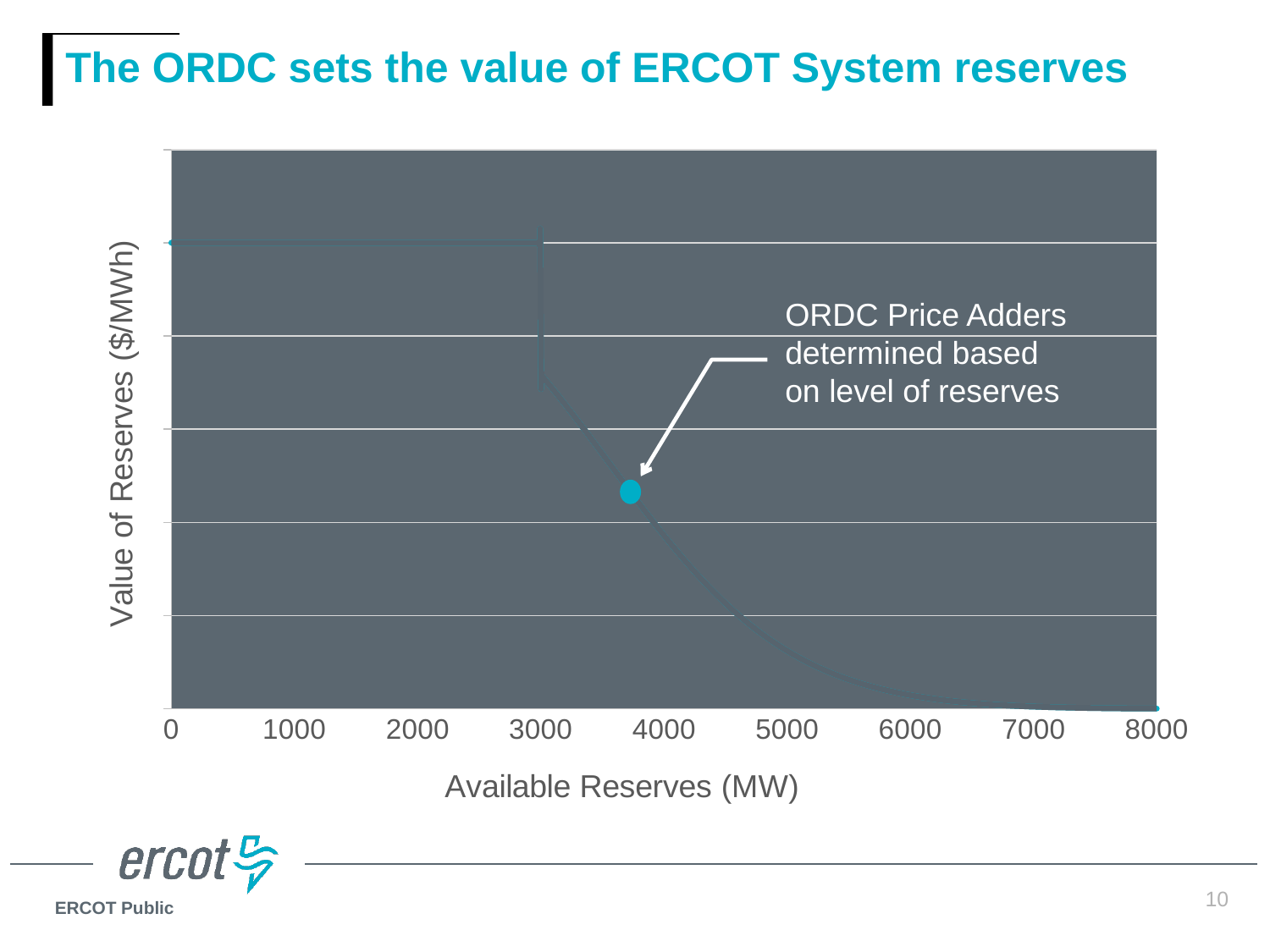
What kind of chart is shown on the slide? Line chart What is the lowest value shown on the x axis of the chart? 0 How many tick labels are shown on the x axis of the chart? 9 What is the highest value shown on the x axis of the chart? 8000 Is the value of reserves at 8000 MW higher or lower than at 6000 MW? Lower Between 0 and 3000 MW of available reserves, does the value of reserves rise, fall, or stay flat? Stay flat As available reserves increase from 3000 MW to 8000 MW, does the value of reserves rise or fall? Fall What is the title of the x axis of the chart? Available Reserves (MW) Is the value of reserves larger at 1000 MW or at 5000 MW of available reserves? 1000 MW What is the title of the y axis of the chart? Value of Reserves ($/MWh) Is the value of reserves larger at 4000 MW or at 7000 MW of available reserves? 4000 MW